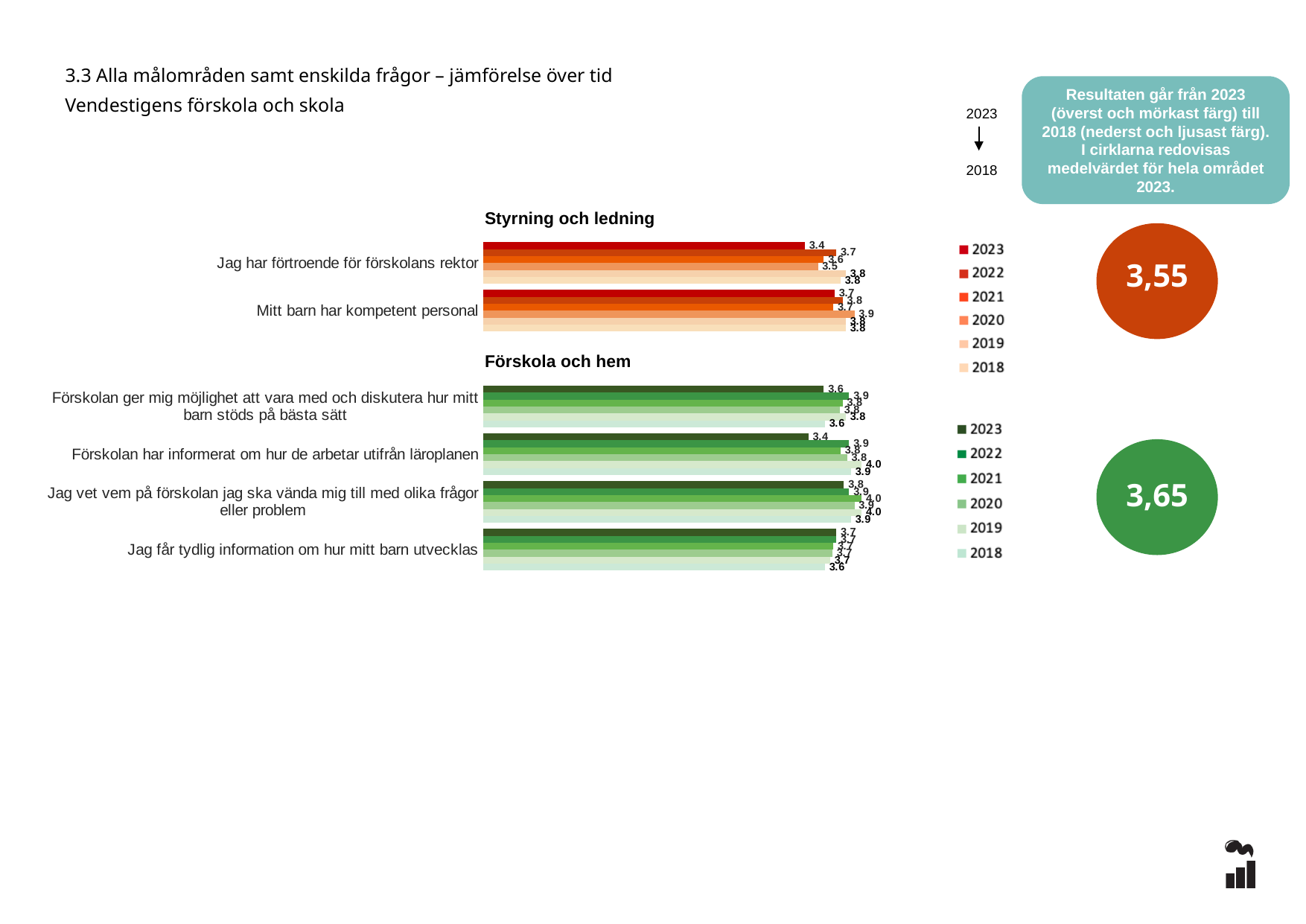
How many questions (categories) are shown in the 'Förskola och hem' chart? 4 In the 'Styrning och ledning' chart, what is the 2023 value for 'Jag har förtroende för förskolans rektor'? 3.4 What kind of chart is the 'Styrning och ledning' chart? Bar chart What mean value for 2023 is shown in the orange circle next to the 'Styrning och ledning' chart? 3,55 In the 'Styrning och ledning' chart, what is the 2023 value for 'Mitt barn har kompetent personal'? 3.7 How many years does the legend of the 'Förskola och hem' chart list? 6 In the 'Förskola och hem' chart, what is the 2023 value for 'Jag vet vem på förskolan jag ska vända mig till med olika frågor eller problem'? 3.8 In the 'Förskola och hem' chart, which question has the lowest 2023 value? Förskolan har informerat om hur de arbetar utifrån läroplanen In the 'Förskola och hem' chart, what is the 2023 value for 'Förskolan har informerat om hur de arbetar utifrån läroplanen'? 3.4 What mean value for 2023 is shown in the green circle next to the 'Förskola och hem' chart? 3,65 In the 'Förskola och hem' chart, what is the difference between the 2023 values for 'Jag vet vem på förskolan jag ska vända mig till med olika frågor eller problem' and 'Förskolan har informerat om hur de arbetar utifrån läroplanen'? 0.4 In the 'Styrning och ledning' chart, which question has the higher 2023 value: 'Jag har förtroende för förskolans rektor' or 'Mitt barn har kompetent personal'? Mitt barn har kompetent personal